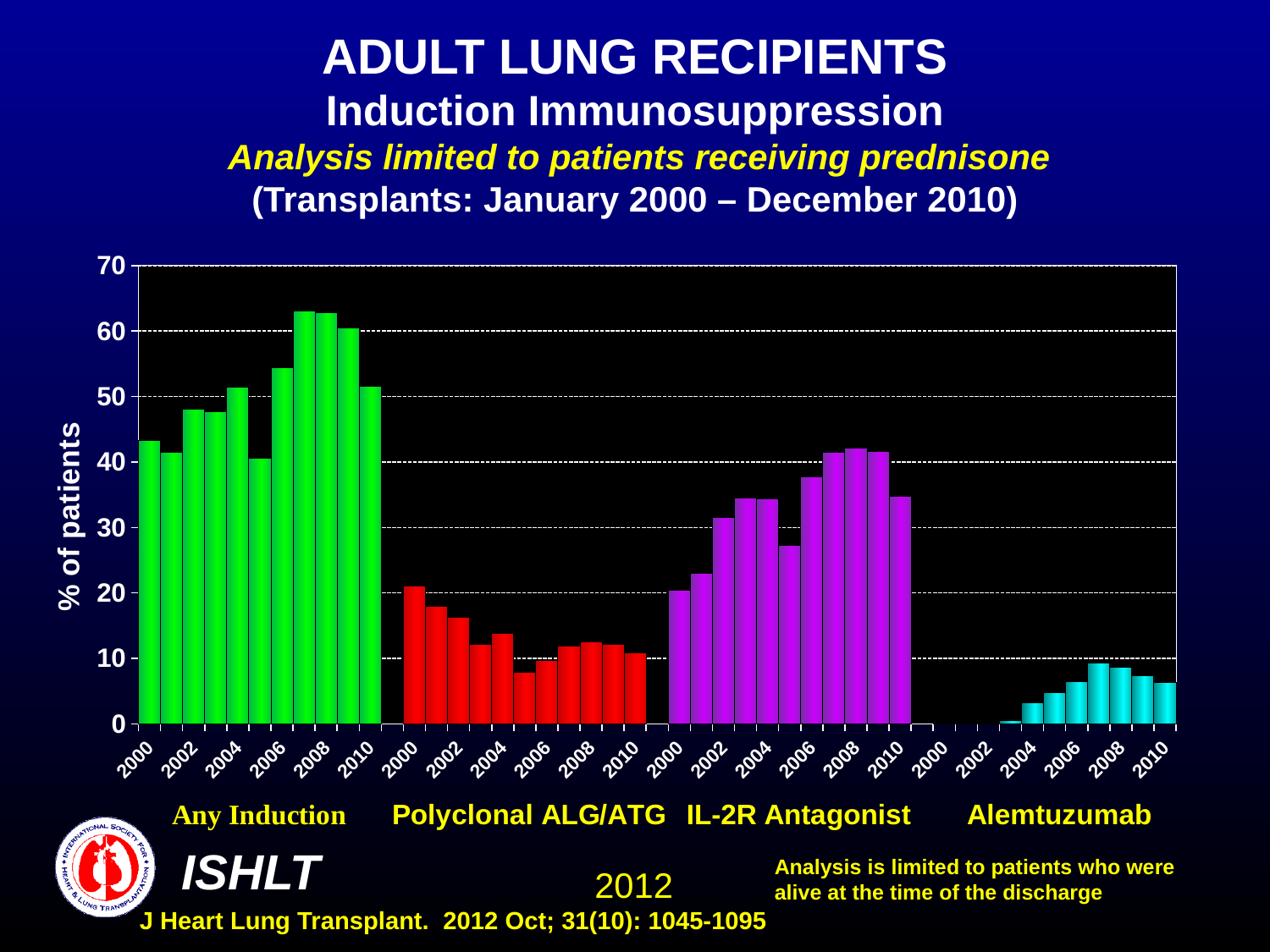
What kind of chart is shown on the slide? bar chart Is the value for IL-2R Antagonist in 2008 greater or less than 40? greater Which is larger in 2008: the value for IL-2R Antagonist or the value for Polyclonal ALG/ATG? IL-2R Antagonist Is the value for Polyclonal ALG/ATG in 2005 greater or less than 10? less Which induction group has the lowest bars overall? Alemtuzumab How many years (bars) are plotted for the Any Induction group? 11 Do the values for IL-2R Antagonist rise or fall from 2000 to 2004? rise Which induction group has the highest bars overall? Any Induction What is the label on the y axis of the chart? % of patients Is the value for Any Induction in 2007 greater or less than 60? greater Do the values for Polyclonal ALG/ATG rise or fall from 2000 to 2005? fall How many induction groups are shown along the x axis of the chart? 4